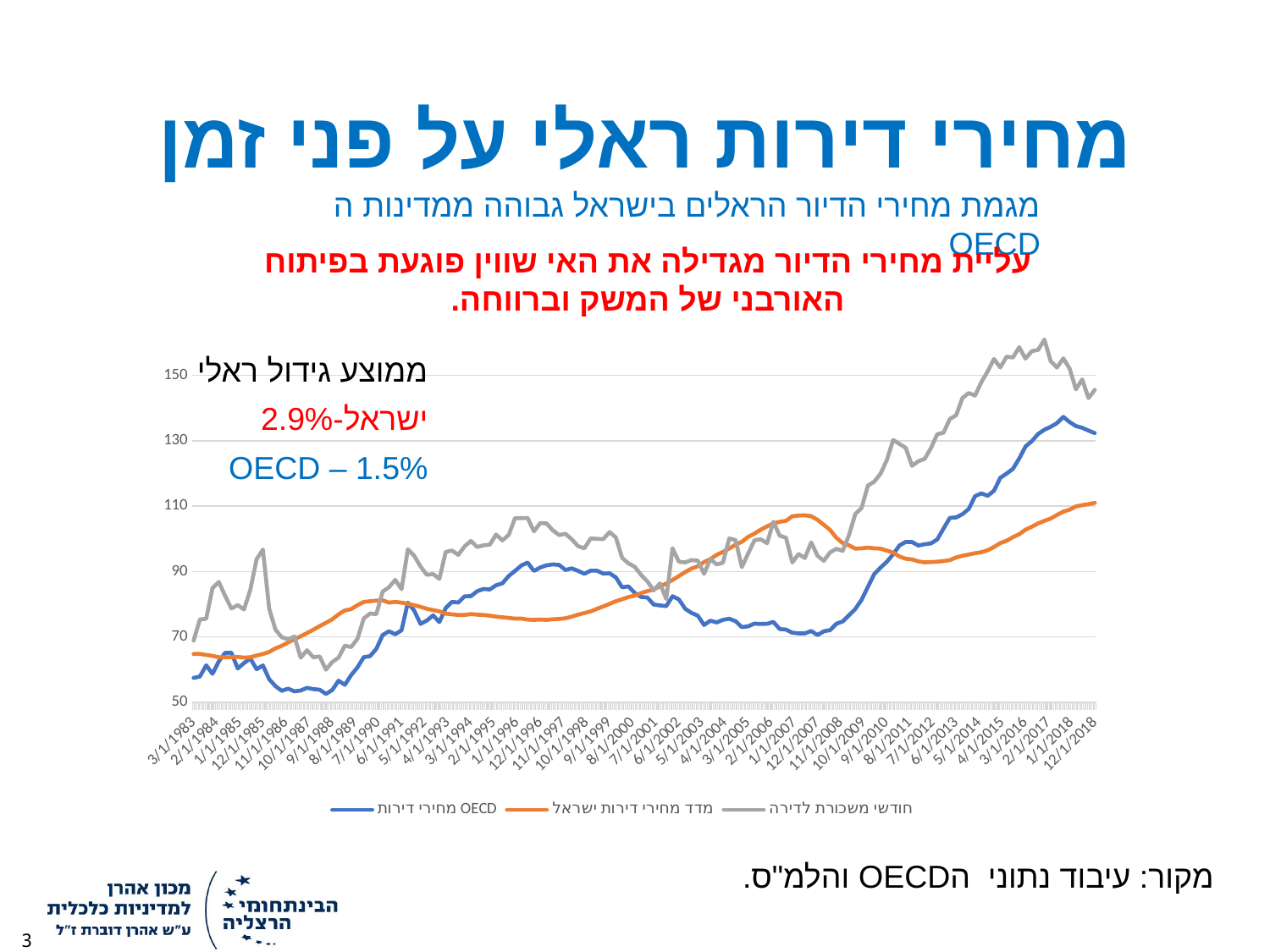
What kind of chart is shown on the slide? line chart Is the value of the blue OECD series around 1987 greater or less than 70? less Is the highest value of the blue OECD series (around 2017) greater or less than 130? greater Does the orange Israel house price index rise or fall between 2009 and 2018? rise Is the peak value of the grey series (חודשי משכורת לדירה) greater or less than 150? greater How many series does the chart's legend list? 3 At the end of the series (12/1/2018), which is higher: the grey series or the blue OECD series? the grey series Does the blue OECD series rise or fall between 1996 and 2007? fall At the end of the series (12/1/2018), which is higher: the blue OECD series or the orange Israel series? the blue OECD series What average real growth rate does the slide annotation give for Israel? 2.9% Which series is drawn in orange according to the legend? מדד מחירי דירות ישראל